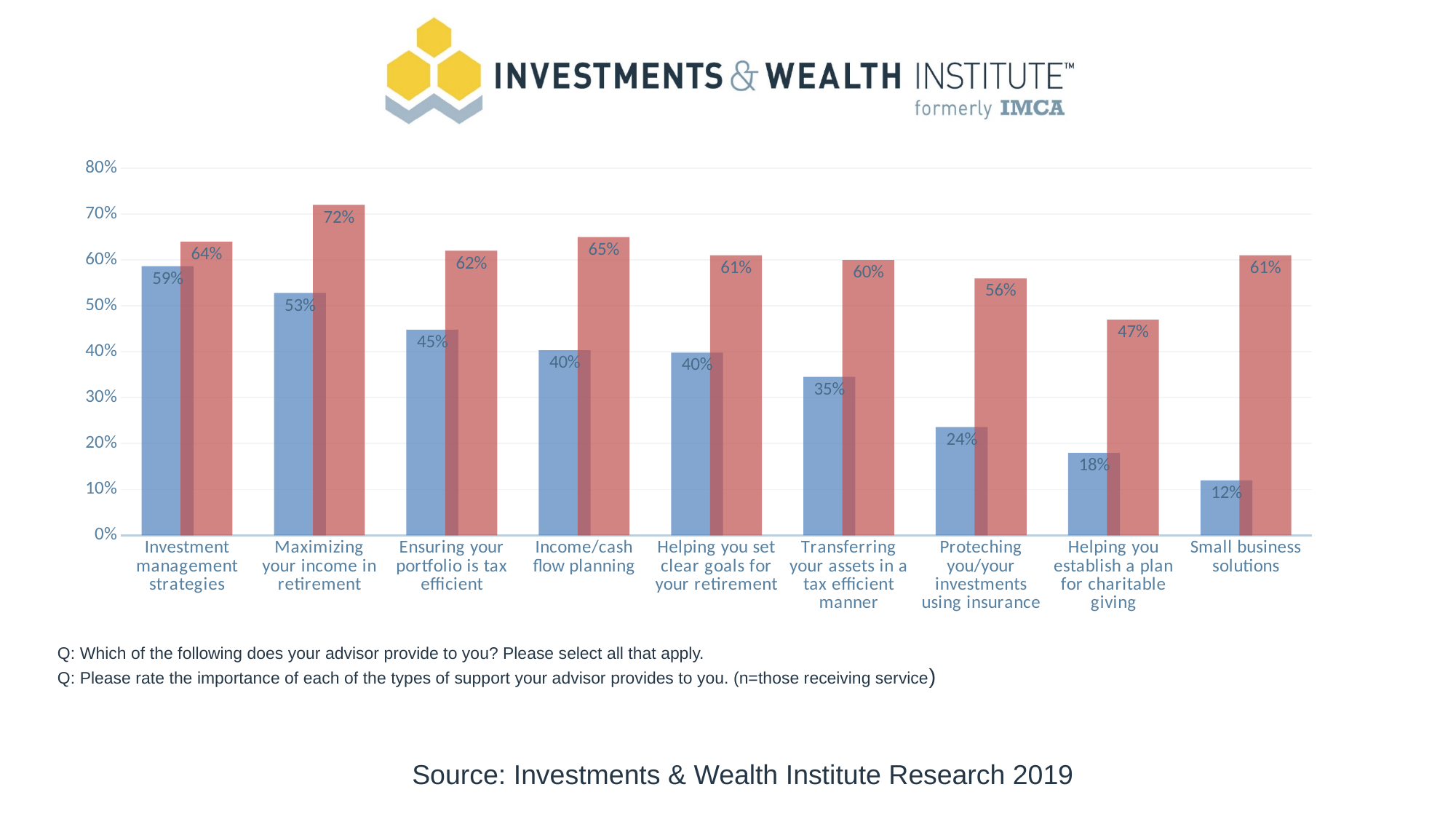
What is the value of the blue bar for Investment management strategies? 59% Which category has the highest red bar? Maximizing your income in retirement Is the value of the red bar for Protecting you/your investments using insurance greater or less than 50%? greater Which is larger for Income/cash flow planning, the blue bar or the red bar? the red bar What is the value of the red bar for Helping you establish a plan for charitable giving? 47% What is the value of the blue bar for Small business solutions? 12% What kind of chart is shown on the slide? bar chart How many categories are shown on the x axis? 9 What is the difference between the red and blue bars for Small business solutions? 49% Which category has the lowest blue bar? Small business solutions What is the value of the red bar for Maximizing your income in retirement? 72% Do the blue bars rise or fall from left to right across the categories? fall